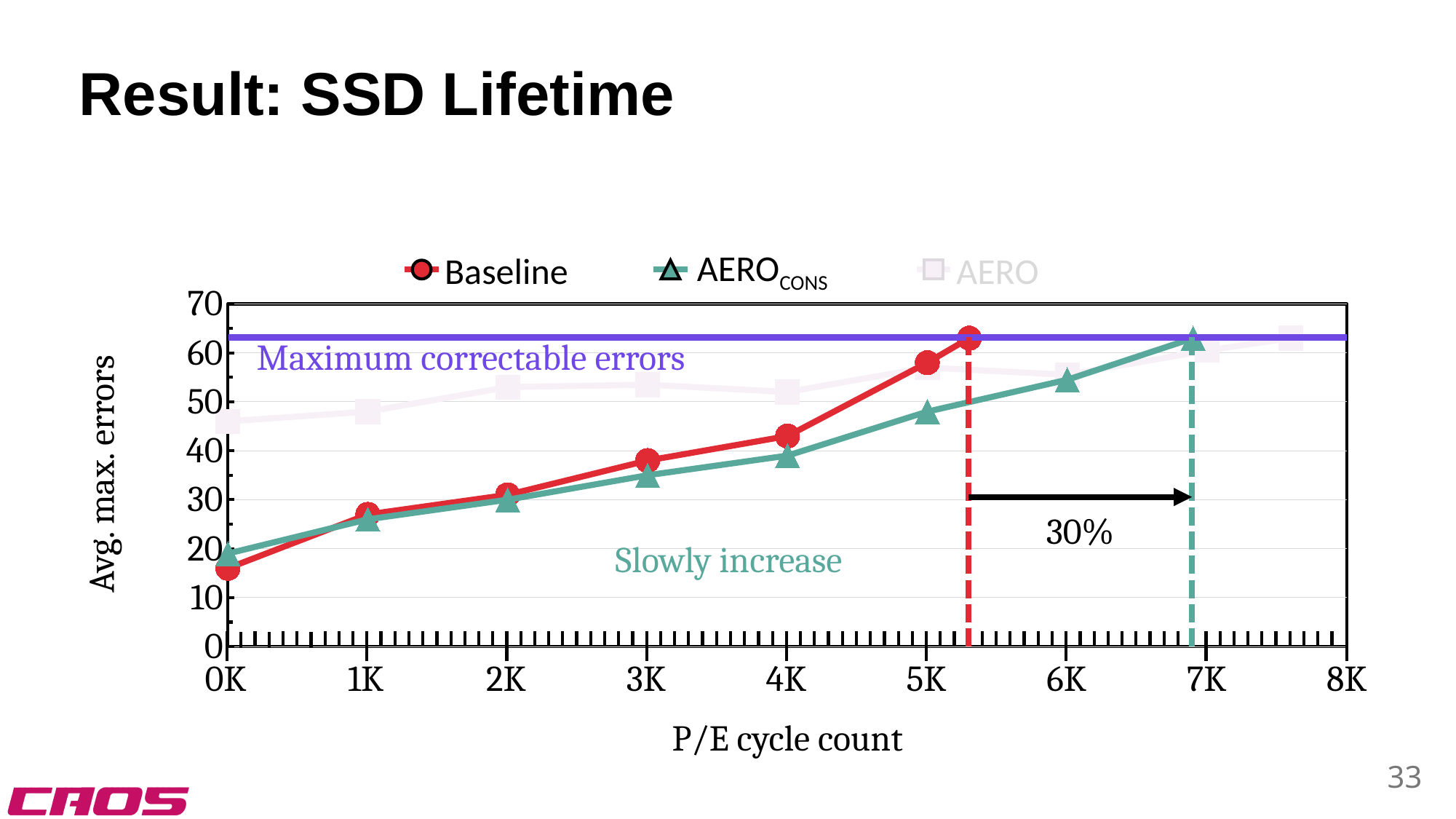
What is the label of the x axis? P/E cycle count At 5K P/E cycles, which series has the higher value, Baseline or AERO_CONS? Baseline Is the AERO_CONS value at 6K P/E cycles greater or less than 50? greater What percentage is printed next to the arrow between the red and green dashed lines? 30% Is the Baseline value at 5K P/E cycles greater or less than 50? greater Is the AERO_CONS value at 3K P/E cycles greater or less than 40? less At 0K P/E cycles, which series has the higher value, Baseline or AERO_CONS? AERO_CONS What kind of chart is shown on the slide? line chart How many data points are plotted for the Baseline series? 7 How many series does the legend list? 3 Do the Baseline values rise or fall as the P/E cycle count increases? rise